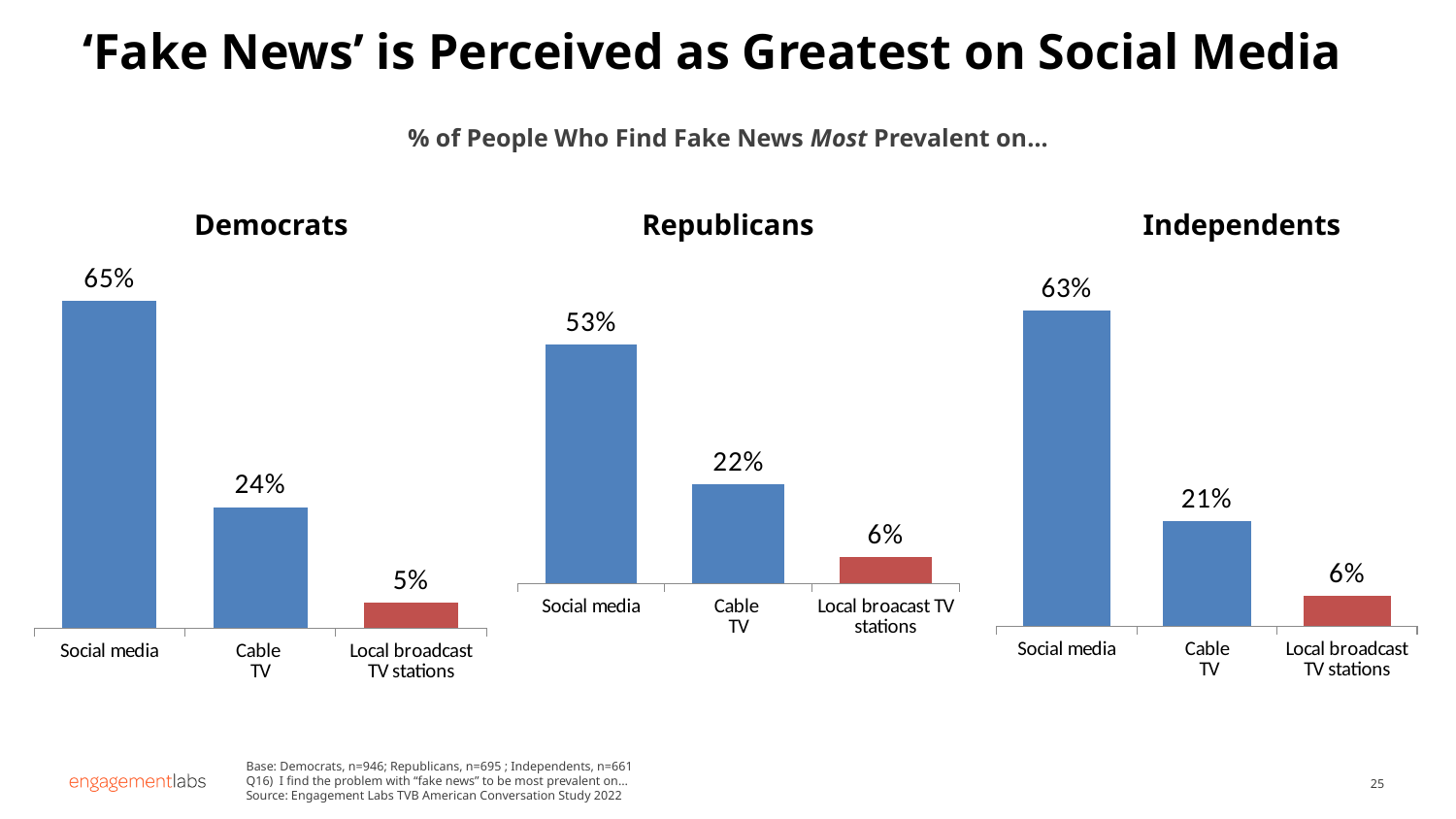
In the Democrats chart, what percentage of people find fake news most prevalent on Social media? 65% In the Democrats chart, which category has the lowest value? Local broadcast TV stations In the Independents chart, do the values rise or fall from left to right? Fall How many categories are shown in the Republicans chart? 3 What colour is the Local broadcast TV stations bar in each chart? Red In the Independents chart, what is the value for Local broadcast TV stations? 6% Which is larger: the Social media value in the Democrats chart or the Social media value in the Republicans chart? Democrats In the Republicans chart, what is the value for Cable TV? 22% What type of chart is the Independents chart? Bar chart In the Independents chart, which category has the highest value? Social media In the Republicans chart, what is the difference between the Social media and Cable TV values? 31% In the Democrats chart, what is the difference between the Cable TV and Local broadcast TV stations values? 19%